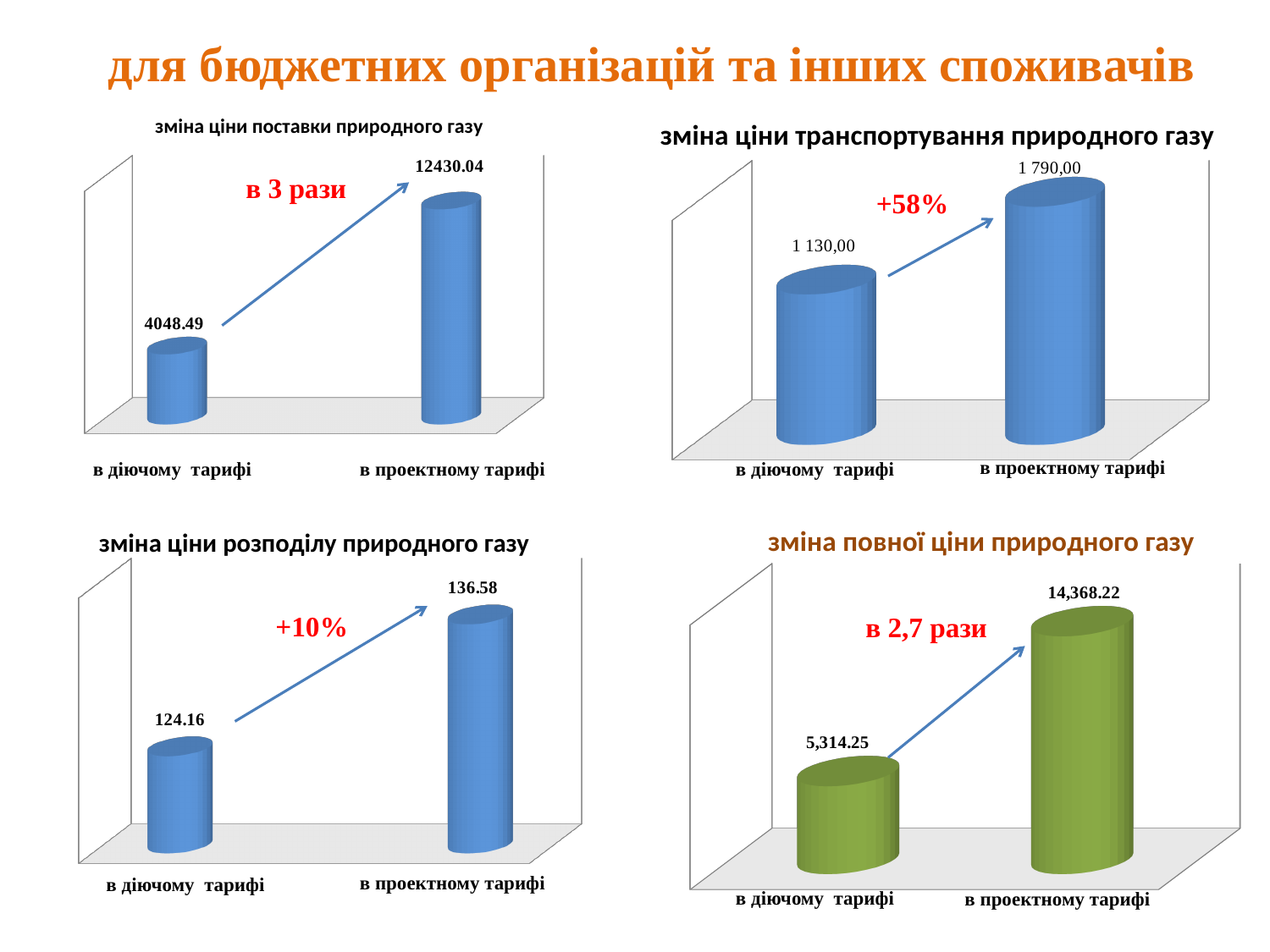
In the chart titled "зміна ціни транспортування природного газу", what is the difference between the value for "в проектному тарифі" and the value for "в діючому тарифі"? 660,00 How many categories are shown in the chart titled "зміна ціни розподілу природного газу"? 2 In the chart titled "зміна повної ціни природного газу", what is the value for "в проектному тарифі"? 14,368.22 In the chart titled "зміна ціни поставки природного газу", which category has the highest value? в проектному тарифі In the chart titled "зміна ціни розподілу природного газу", what is the value for "в діючому тарифі"? 124.16 In the chart titled "зміна ціни транспортування природного газу", what is the value for "в проектному тарифі"? 1 790,00 In the chart titled "зміна ціни розподілу природного газу", what is the difference between the value for "в проектному тарифі" and the value for "в діючому тарифі"? 12.42 What kind of chart is the one titled "зміна повної ціни природного газу"? bar chart In the chart titled "зміна ціни поставки природного газу", what is the value for "в проектному тарифі"? 12430.04 In the chart titled "зміна повної ціни природного газу", which category has the lowest value? в діючому тарифі In the chart titled "зміна ціни поставки природного газу", what is the value for "в діючому тарифі"? 4048.49 In the chart titled "зміна ціни транспортування природного газу", which is larger: the value for "в діючому тарифі" or the value for "в проектному тарифі"? в проектному тарифі